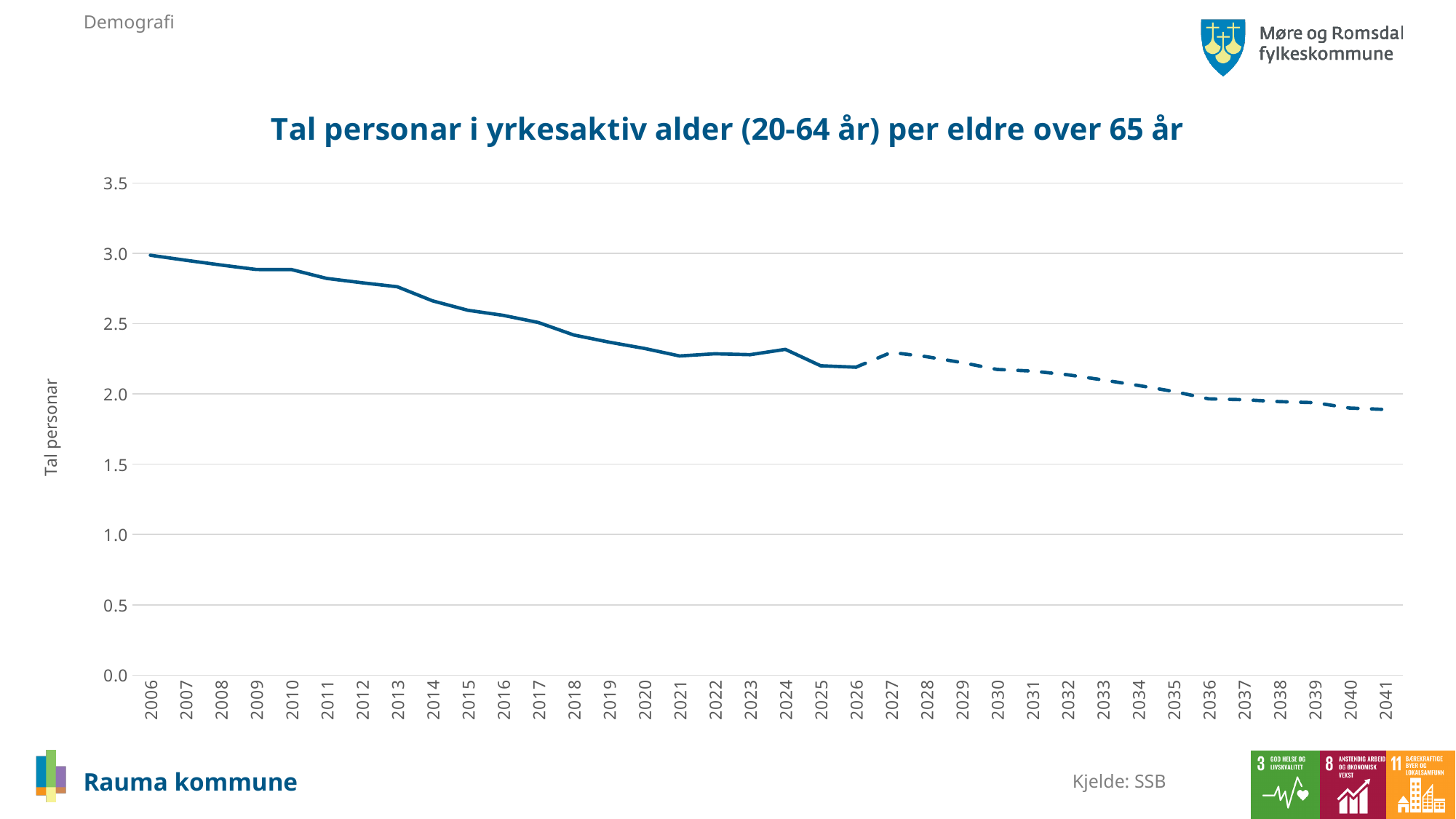
Is the value for 2021 greater or less than 2.5? less Which year has the highest value in the chart? 2006 How many years are shown along the x axis of the chart? 36 What is the title of the chart? Tal personar i yrkesaktiv alder (20-64 år) per eldre over 65 år Is the value for 2010 greater or less than 2.5? greater What is the label on the vertical axis of the chart? Tal personar Which year has the lowest value in the chart? 2041 Which year has the larger value, 2006 or 2041? 2006 Is the value for 2041 greater or less than 2.0? less Do the values generally rise or fall from 2006 to 2041? fall What kind of chart is shown on the slide? line chart